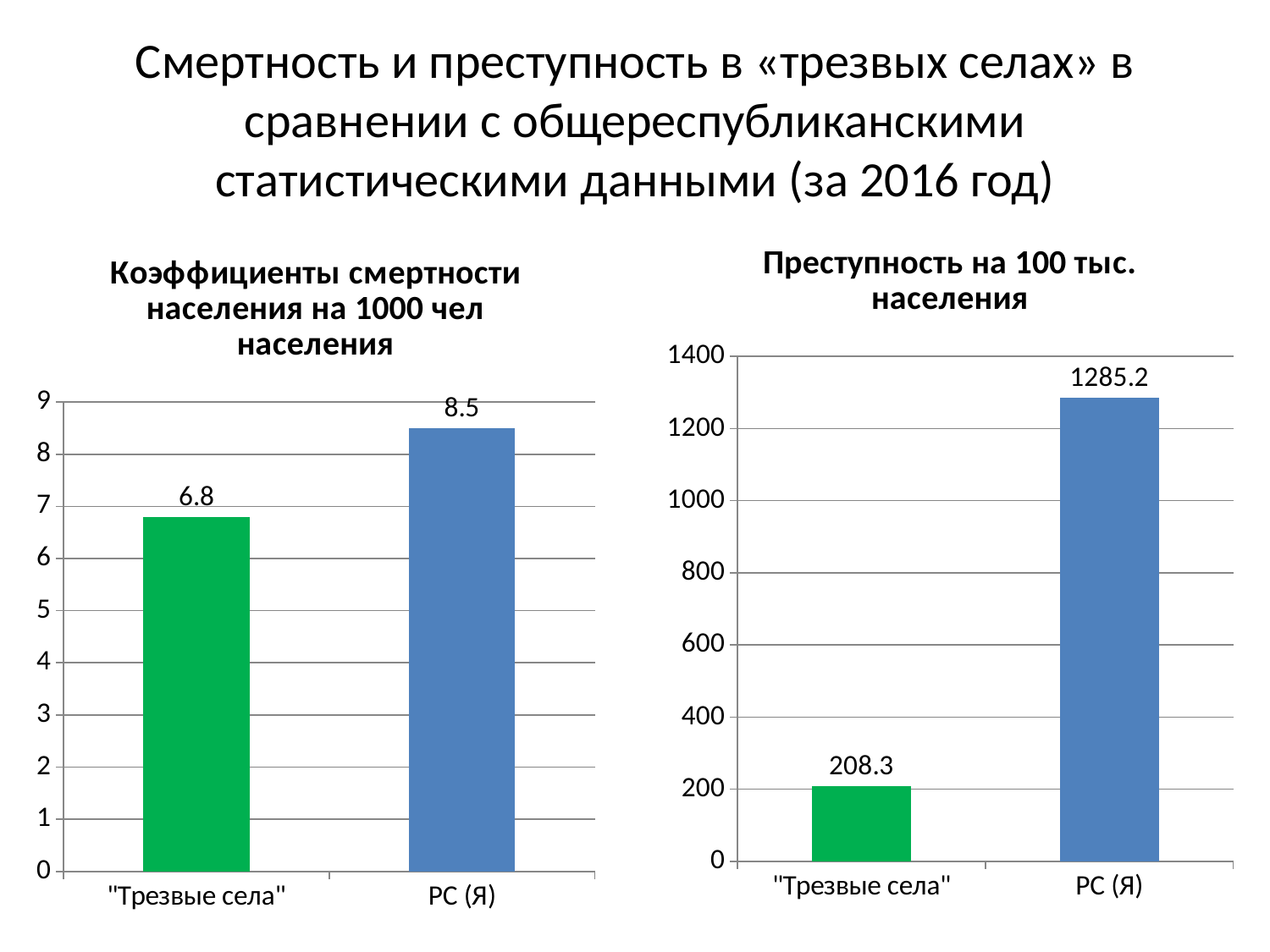
In the right chart (Преступность на 100 тыс. населения), what is the value for РС (Я)? 1285.2 In the right chart (Преступность на 100 тыс. населения), which category has the lowest value? "Трезвые села" How many categories are shown in the left chart (Коэффициенты смертности населения на 1000 чел населения)? 2 What is the title of the right chart on the slide? Преступность на 100 тыс. населения In the right chart (Преступность на 100 тыс. населения), what is the difference between the values for РС (Я) and "Трезвые села"? 1076.9 In the right chart (Преступность на 100 тыс. населения), what is the value for "Трезвые села"? 208.3 In the left chart (Коэффициенты смертности населения на 1000 чел населения), what is the value for "Трезвые села"? 6.8 In the left chart (Коэффициенты смертности населения на 1000 чел населения), what is the difference between the values for РС (Я) and "Трезвые села"? 1.7 In the right chart (Преступность на 100 тыс. населения), is the value for "Трезвые села" greater or less than 400? less In the left chart (Коэффициенты смертности населения на 1000 чел населения), what is the value for РС (Я)? 8.5 In the left chart (Коэффициенты смертности населения на 1000 чел населения), which category has the higher value? РС (Я) What kind of chart is the right chart (Преступность на 100 тыс. населения)? bar chart